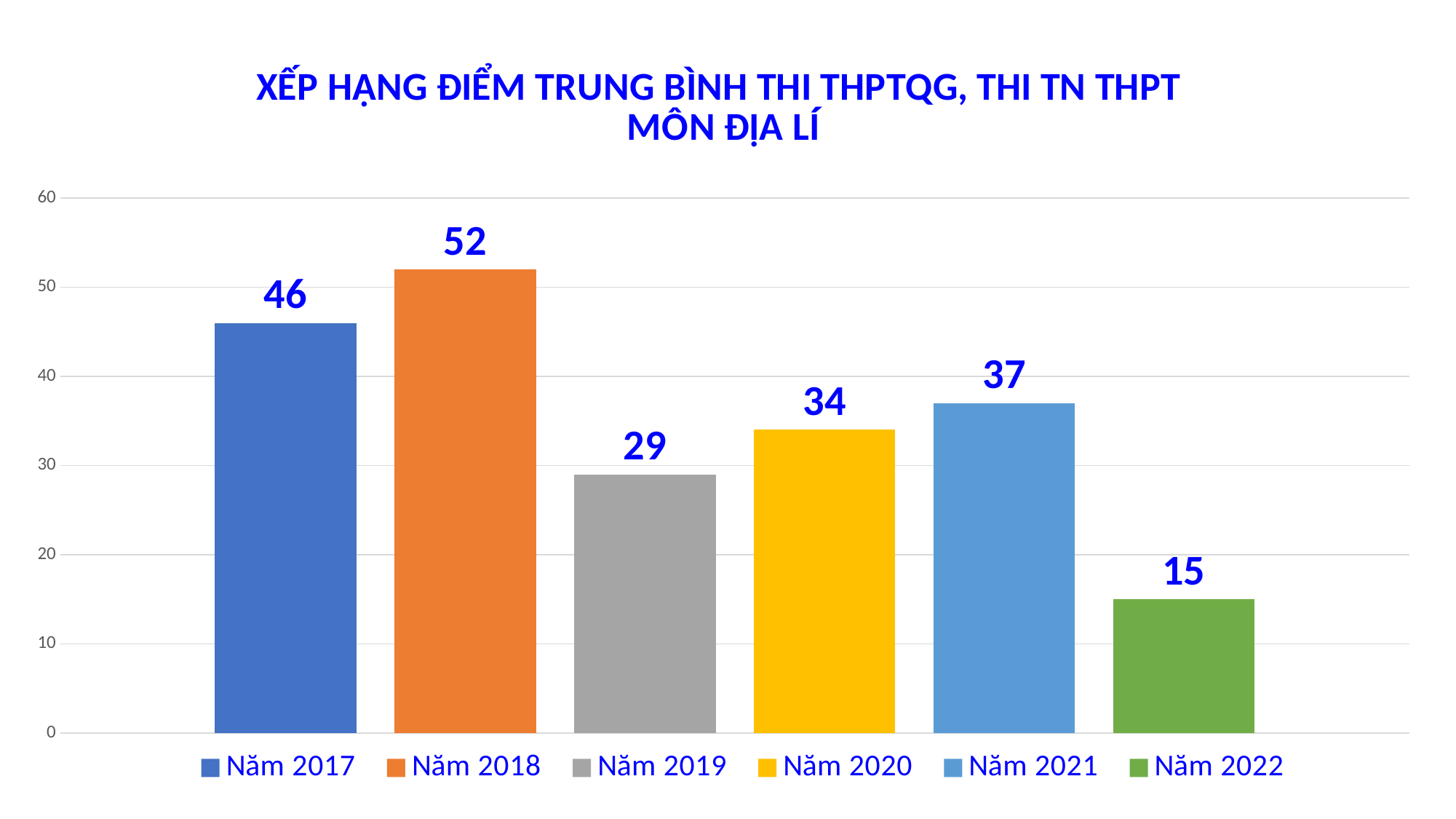
What kind of chart is shown on the slide? bar chart What is the value for Năm 2022? 15 What colour is the bar for Năm 2020? yellow What is the difference between the values for Năm 2018 and Năm 2019? 23 Which year has the highest value? Năm 2018 What is the difference between the values for Năm 2021 and Năm 2022? 22 Is the value for Năm 2019 greater or less than 30? less What is the value for Năm 2020? 34 Which is larger, the value for Năm 2020 or the value for Năm 2021? Năm 2021 What is the value for Năm 2017? 46 How many years are shown in the chart? 6 Which year has the lowest value? Năm 2022